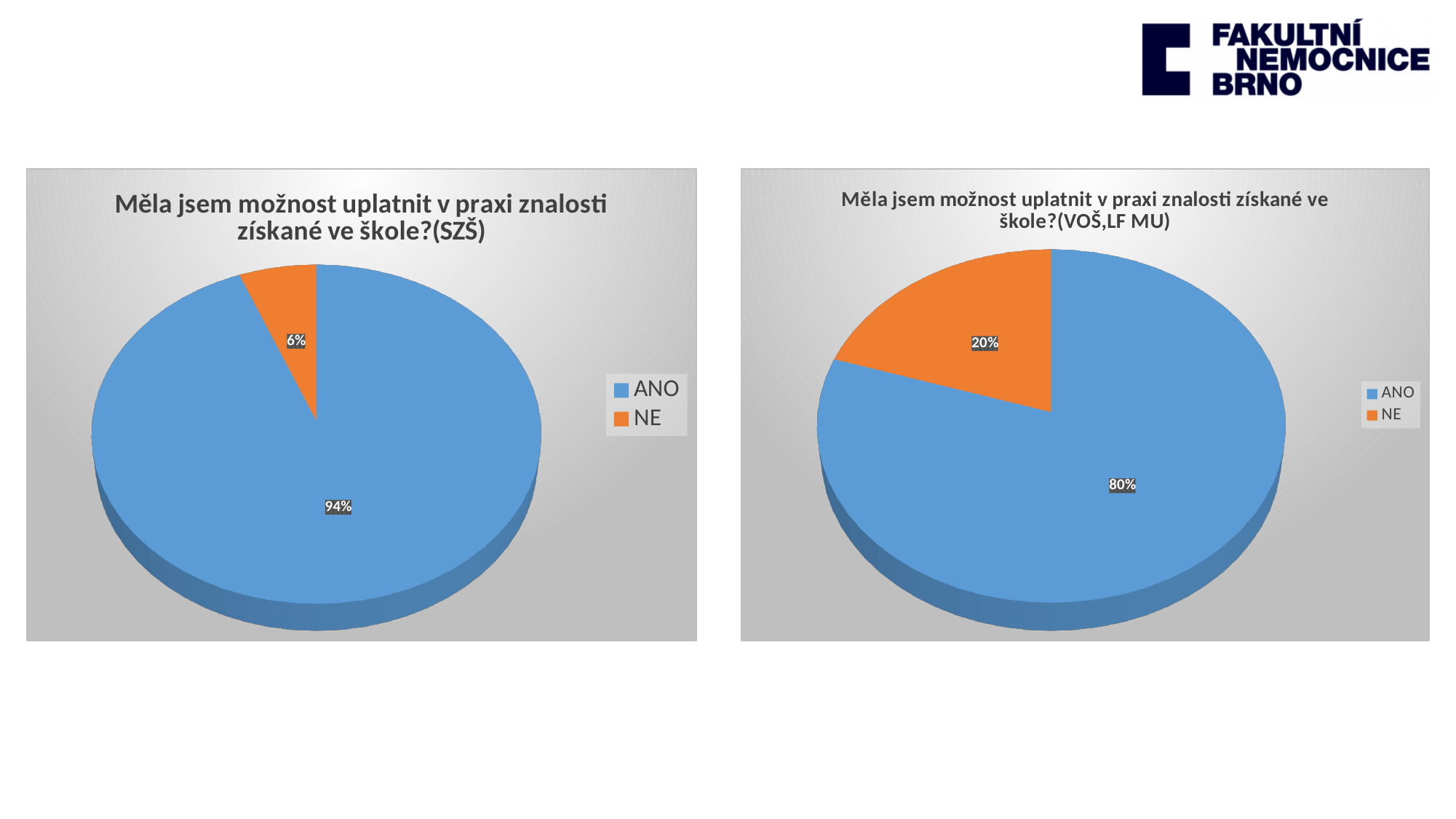
Is the NE share larger in the left chart (SZŠ) or in the right chart (VOŠ, LF MU)? right chart (VOŠ, LF MU) In the left chart (SZŠ), what percentage of respondents answered ANO? 94% In the right chart (VOŠ, LF MU), what percentage of respondents answered ANO? 80% In the left chart (SZŠ), what is the difference in percentage points between ANO and NE? 88 How many categories does the legend of the right chart (VOŠ, LF MU) list? 2 In the left chart (SZŠ), what colour represents the ANO slice? blue In the left chart (SZŠ), what percentage of respondents answered NE? 6% In the right chart (VOŠ, LF MU), what is the difference in percentage points between ANO and NE? 60 What type of chart is the left chart (SZŠ)? pie chart In the right chart (VOŠ, LF MU), which answer has the smallest share? NE In the right chart (VOŠ, LF MU), what percentage of respondents answered NE? 20% In the left chart (SZŠ), which answer has the largest share? ANO